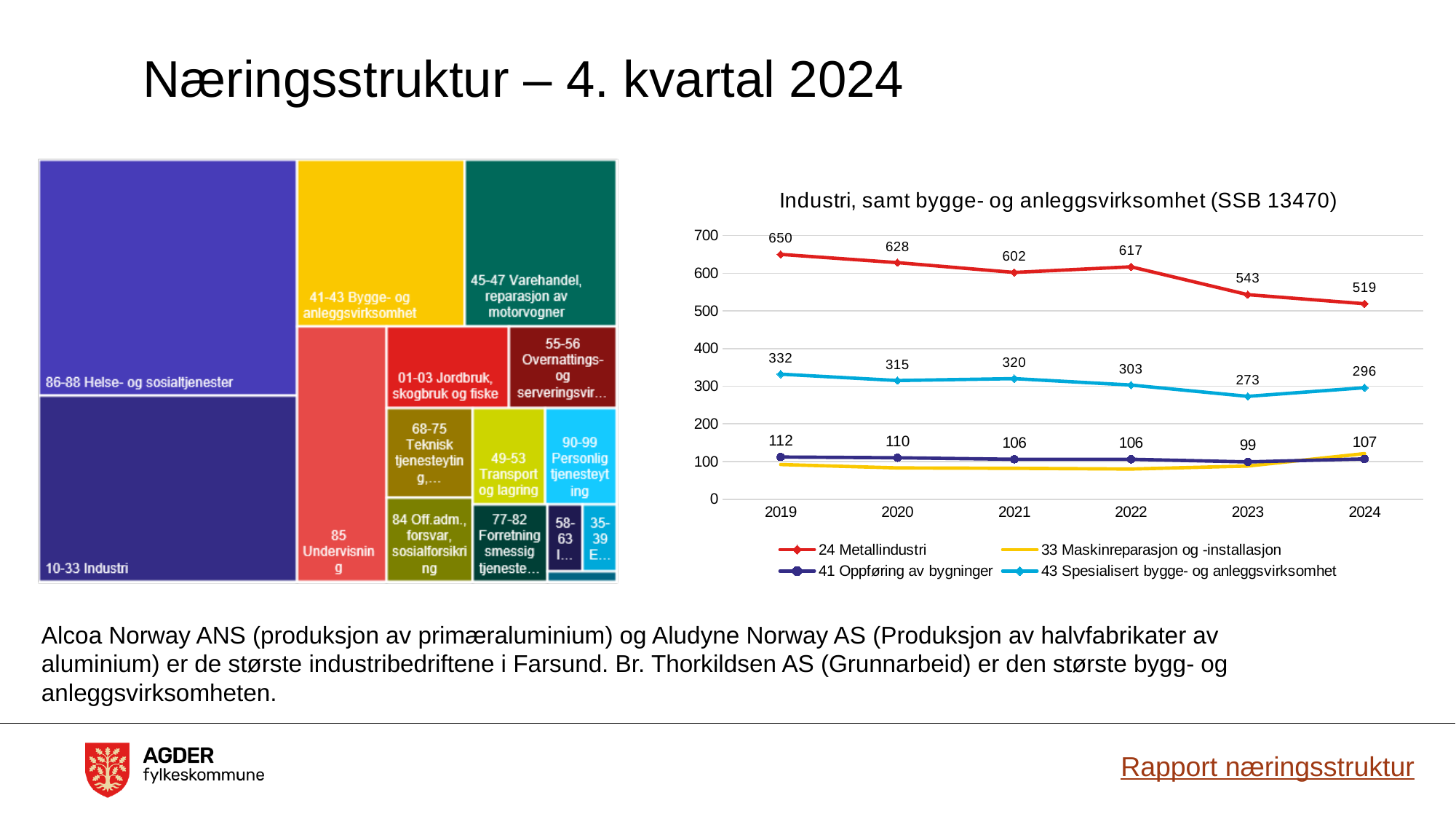
In the line chart 'Industri, samt bygge- og anleggsvirksomhet (SSB 13470)', in which year is 24 Metallindustri lowest? 2024 In the line chart 'Industri, samt bygge- og anleggsvirksomhet (SSB 13470)', what is the value for 24 Metallindustri in 2024? 519 How many series does the legend of the line chart 'Industri, samt bygge- og anleggsvirksomhet (SSB 13470)' list? 4 In the line chart 'Industri, samt bygge- og anleggsvirksomhet (SSB 13470)', what is the value for 41 Oppføring av bygninger in 2019? 112 In the line chart 'Industri, samt bygge- og anleggsvirksomhet (SSB 13470)', is the value for 33 Maskinreparasjon og -installasjon in 2022 greater or less than 100? less In the line chart 'Industri, samt bygge- og anleggsvirksomhet (SSB 13470)', is the value for 24 Metallindustri higher in 2021 or in 2022? 2022 In the line chart 'Industri, samt bygge- og anleggsvirksomhet (SSB 13470)', does 24 Metallindustri generally rise or fall from 2019 to 2024? fall What kind of chart is the chart on the right of the slide, titled 'Industri, samt bygge- og anleggsvirksomhet (SSB 13470)'? line chart In the line chart 'Industri, samt bygge- og anleggsvirksomhet (SSB 13470)', what is the value for 24 Metallindustri in 2019? 650 In the line chart 'Industri, samt bygge- og anleggsvirksomhet (SSB 13470)', by how much did 24 Metallindustri decrease from 2019 to 2024? 131 In the line chart 'Industri, samt bygge- og anleggsvirksomhet (SSB 13470)', what is the value for 43 Spesialisert bygge- og anleggsvirksomhet in 2023? 273 In the line chart 'Industri, samt bygge- og anleggsvirksomhet (SSB 13470)', in which year is 43 Spesialisert bygge- og anleggsvirksomhet highest? 2019